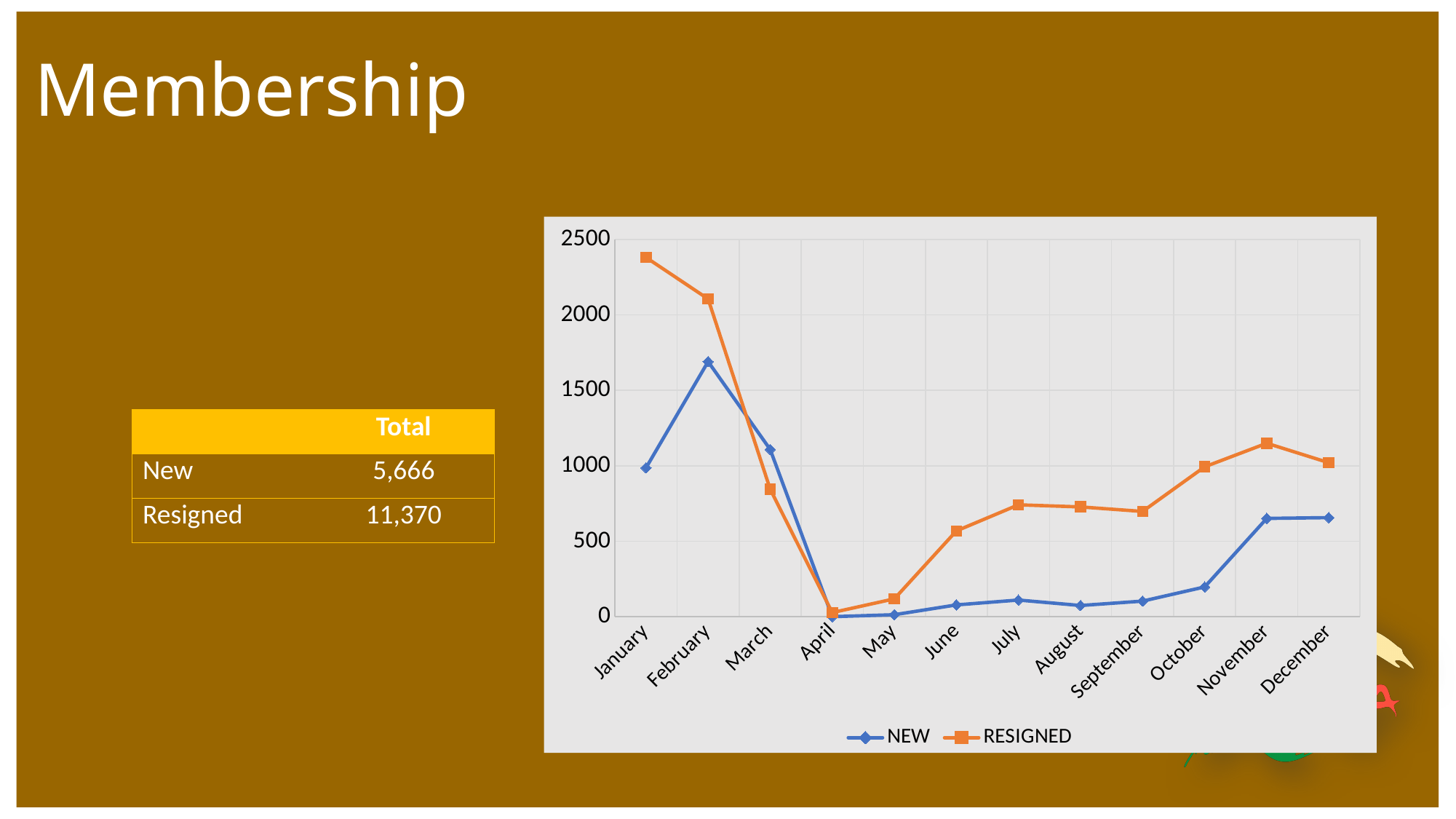
Does the RESIGNED series rise or fall from January to April? fall Is the NEW value for October greater or less than 500? less Is the NEW value for February greater or less than 1500? greater In January, which series has the larger value, NEW or RESIGNED? RESIGNED In which month does the RESIGNED series reach its highest value? January In which month does the NEW series reach its highest value? February In which month does the RESIGNED series reach its lowest value? April Is the RESIGNED value for January greater or less than 2000? greater In March, which series has the larger value, NEW or RESIGNED? NEW What kind of chart is shown on the slide? line chart How many months are plotted along the x axis of the chart? 12 How many series does the chart legend list? 2